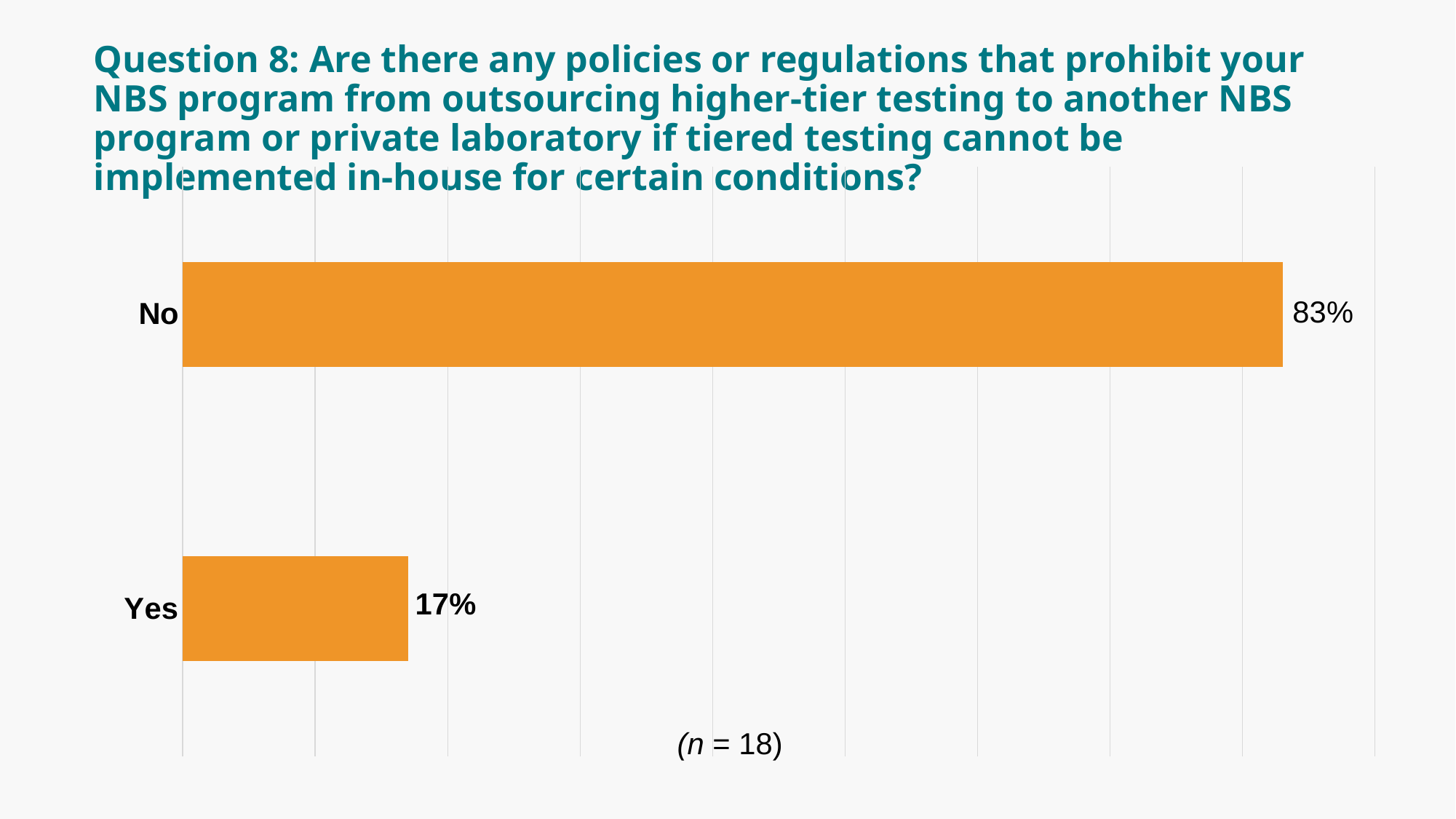
What is the sample size (n) noted on the chart? 18 What percentage of respondents answered "Yes"? 17% What colour are the bars in the chart? Orange Which response category has the lowest value? Yes Which response category has the highest value? No How many response categories are shown in the chart? 2 What kind of chart is shown on the slide? Bar chart What is the difference in percentage points between the "No" and "Yes" responses? 66 Which is larger, the value for "No" or the value for "Yes"? No What percentage of respondents answered "No"? 83%